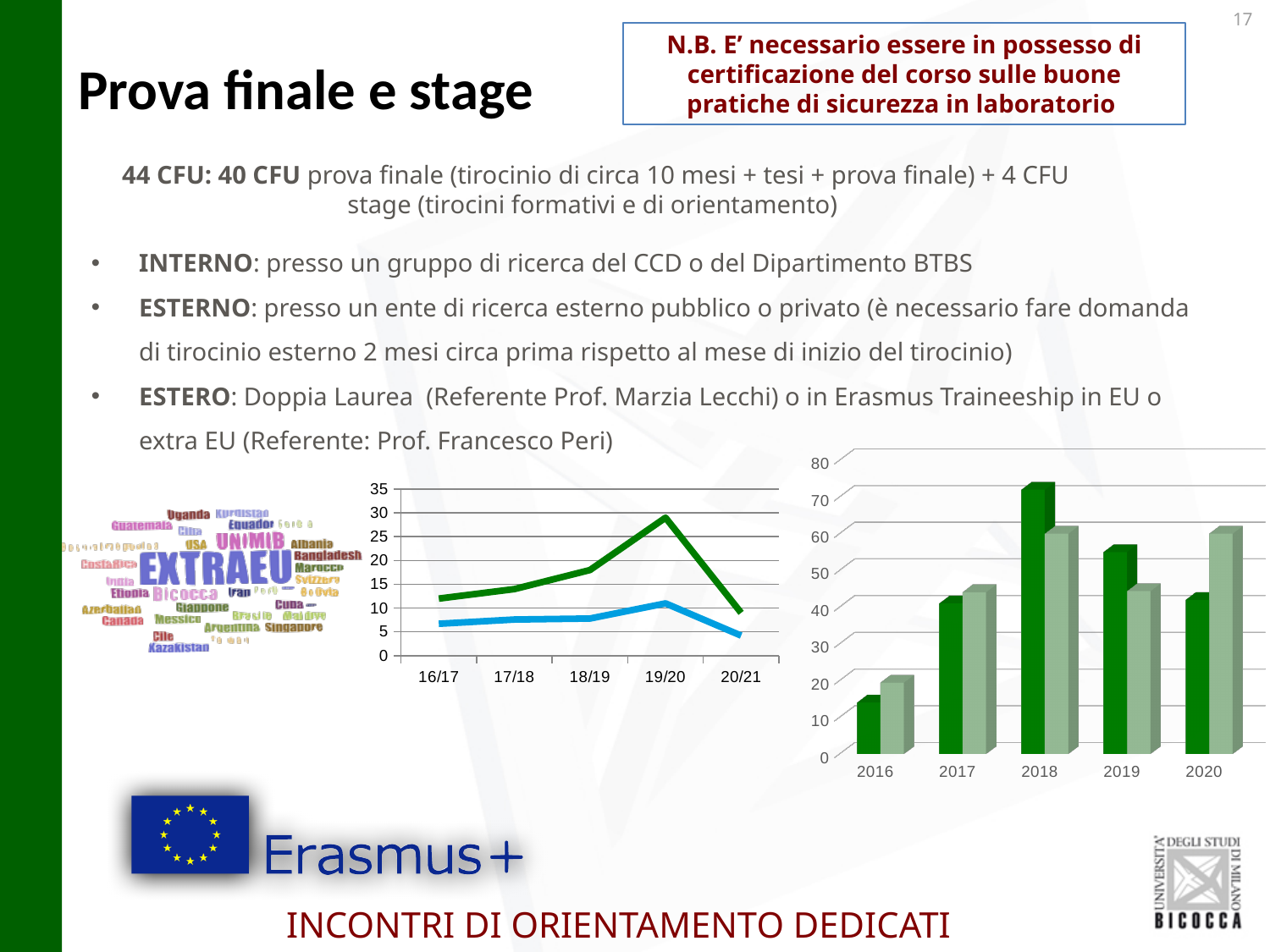
In the bar chart on the right, is the dark green bar for 2016 greater or less than 20? less What kind of chart is the chart on the left with the 16/17 to 20/21 axis? line chart In the line chart on the left, is the value of the green line at 19/20 greater or less than 25? greater What kind of chart is the chart on the right with the 2016 to 2020 axis? bar chart In the line chart on the left, does the green line rise or fall from 16/17 to 19/20? rises In the line chart on the left, how many lines are plotted? 2 In the bar chart on the right, which year has the shortest dark green bar? 2016 In the line chart on the left, is the value of the green line at 20/21 greater or less than 15? less In the bar chart on the right, how many years are shown on the x axis? 5 In the line chart on the left, in which academic year does the green line reach its highest value? 19/20 In the line chart on the left, how many academic years are shown on the x axis? 5 In the bar chart on the right, which year has the tallest dark green bar? 2018